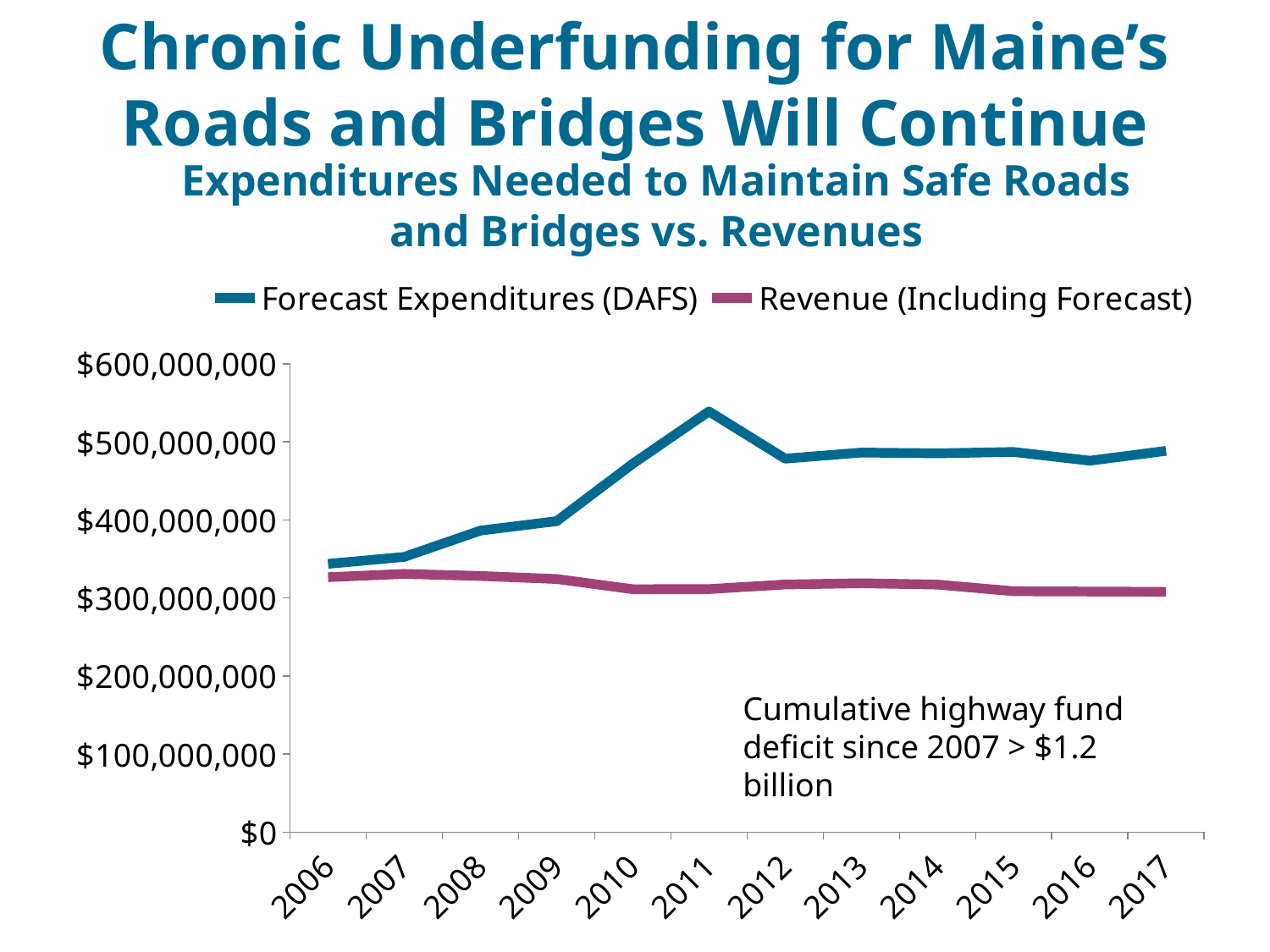
What is the title of the chart? Expenditures Needed to Maintain Safe Roads and Bridges vs. Revenues What kind of chart is shown on the slide? line chart Is the value for Revenue (Including Forecast) in 2006 greater or less than $300,000,000? greater Is the value for Forecast Expenditures (DAFS) in 2011 greater or less than $500,000,000? greater In which year does Forecast Expenditures (DAFS) reach its highest value? 2011 Is the value for Forecast Expenditures (DAFS) in 2006 greater or less than $400,000,000? less How many years are plotted along the x axis? 12 How many series does the legend list? 2 Does the Forecast Expenditures (DAFS) line rise or fall from 2006 to 2011? rise In 2011, which series has the larger value, Forecast Expenditures (DAFS) or Revenue (Including Forecast)? Forecast Expenditures (DAFS) In which year is Forecast Expenditures (DAFS) at its lowest value? 2006